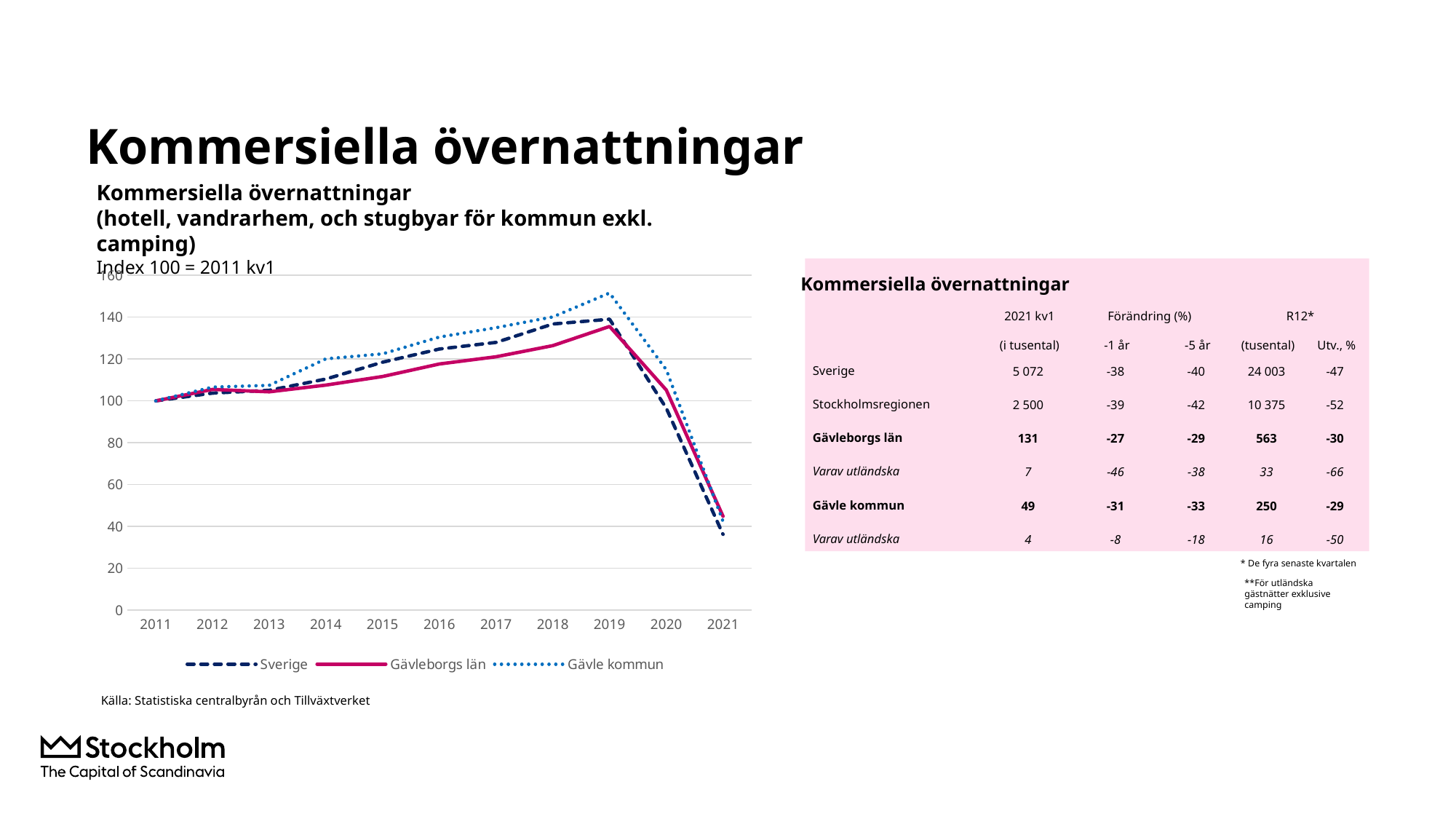
What is the index base stated above the chart? Index 100 = 2011 kv1 How many series does the chart legend list? 3 In which year does the Gävle kommun line reach its peak? 2019 How many years are shown on the x axis of the chart? 11 Is the value for Sverige in 2021 greater or less than 40? less In 2017, which is higher: Gävle kommun or Gävleborgs län? Gävle kommun What kind of chart is shown on the slide? Line chart Which series has the lowest value in 2021? Sverige Is the value for Gävle kommun in 2019 greater or less than 140? greater Which series reaches the highest value in 2019? Gävle kommun Is the value for Gävleborgs län in 2019 greater or less than 140? less Do the lines rise or fall between 2019 and 2021? Fall